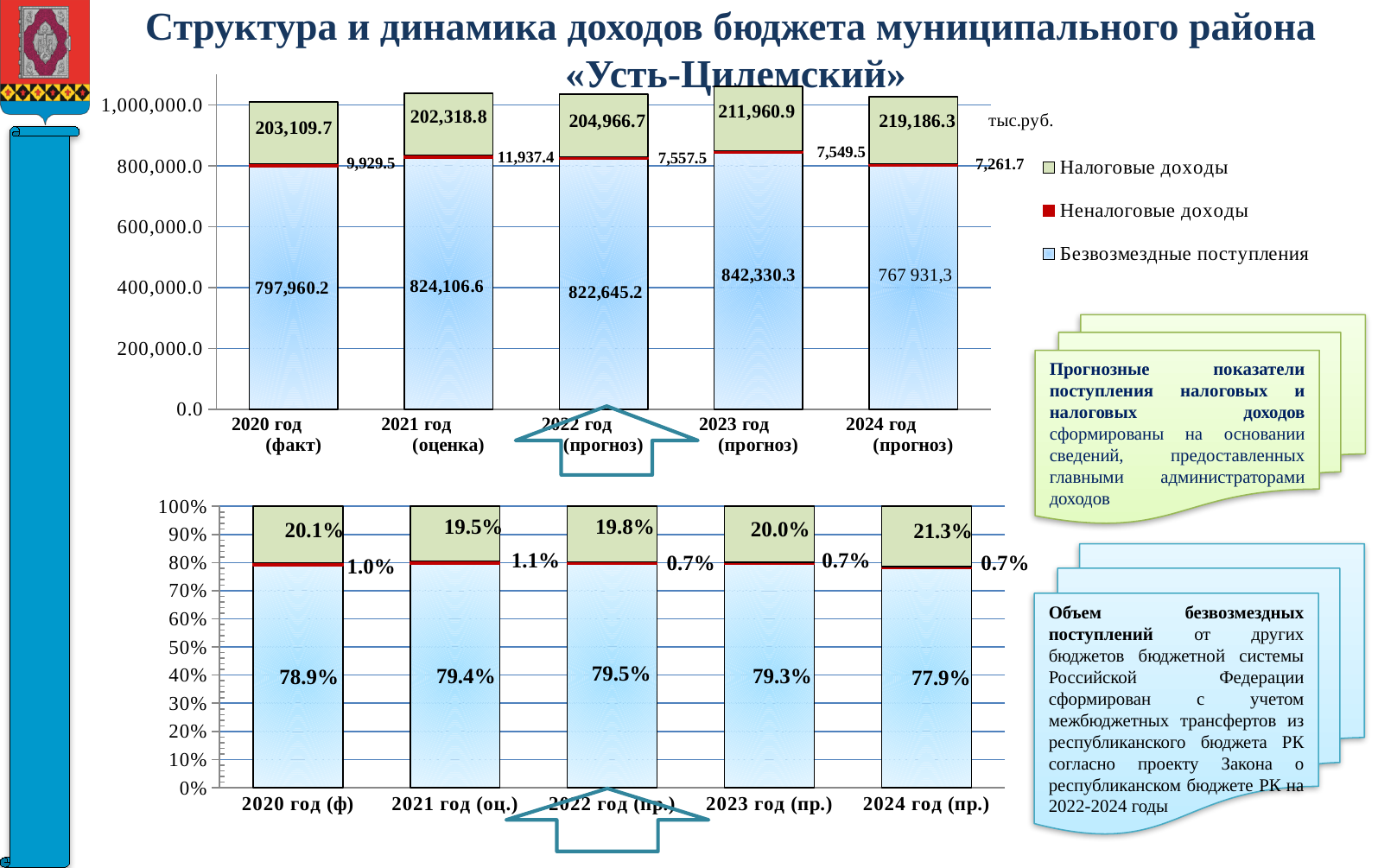
What kind of chart is the bottom chart? Stacked bar chart In the top chart, what is the value of Безвозмездные поступления for 2021 год (оценка)? 824,106.6 In the top chart, which year has the lowest value of Неналоговые доходы? 2024 год (прогноз) In the top chart, what is the difference between Налоговые доходы in 2024 год (прогноз) and in 2020 год (факт)? 16,076.6 In the bottom chart, which year has the highest share of Налоговые доходы? 2024 год (пр.) How many series does the legend of the top chart list? 3 In the top chart, what is the total of the stacked bar for 2020 год (факт)? 1,010,999.4 In the top chart, what is the value of Налоговые доходы for 2020 год (факт)? 203,109.7 In the top chart, what is the value of Неналоговые доходы for 2022 год (прогноз)? 7,557.5 In the bottom chart, what is the share of Безвозмездные поступления for 2022 год (пр.)? 79.5% In the top chart, is Неналоговые доходы larger in 2021 год (оценка) or in 2020 год (факт)? 2021 год (оценка) In the top chart, which year has the highest value of Безвозмездные поступления? 2023 год (прогноз)